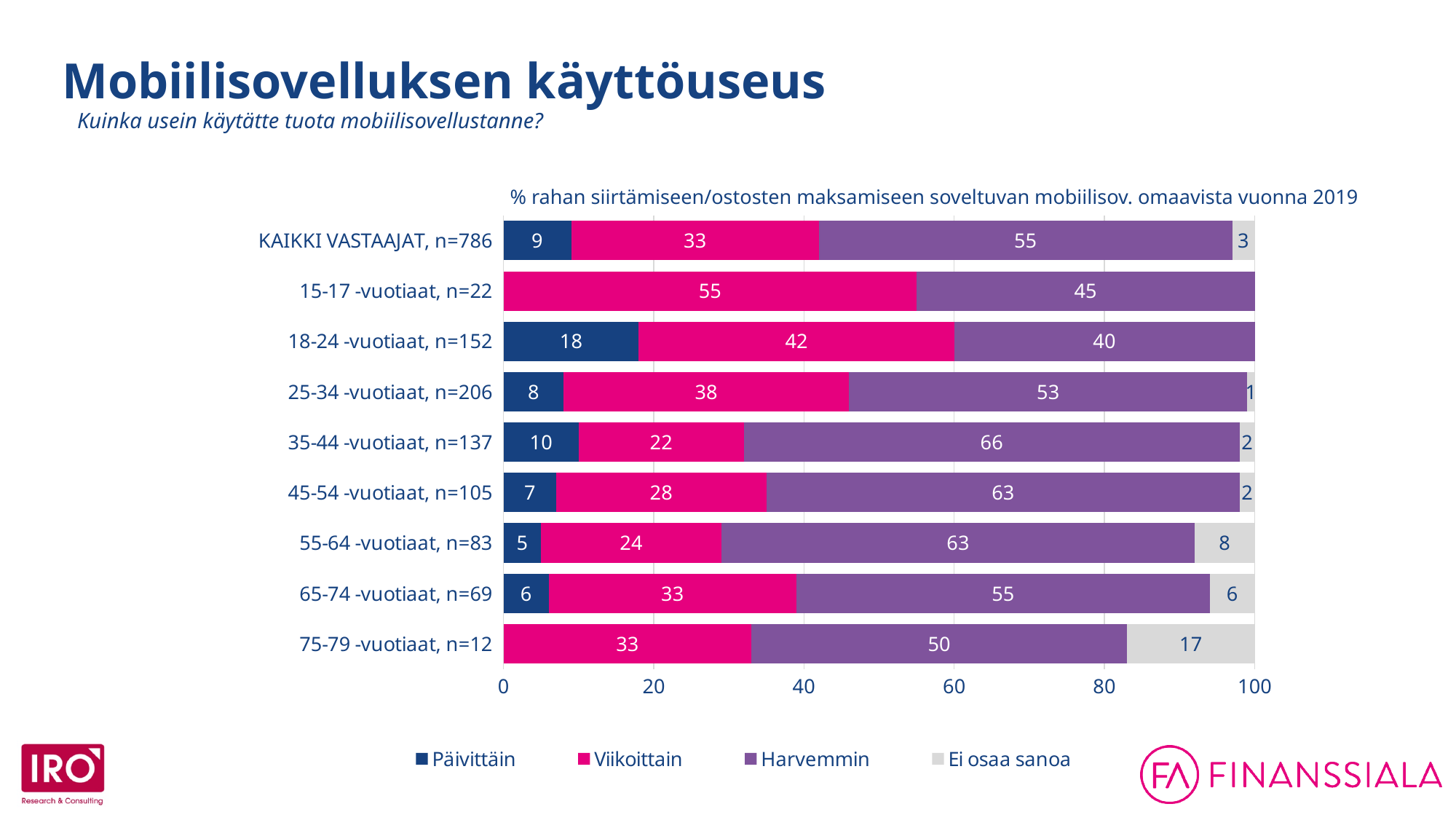
What is the total of the stacked bar for KAIKKI VASTAAJAT, n=786? 100 Which group has the lowest Harvemmin value? 18-24 -vuotiaat, n=152 What is the difference between the Viikoittain values for 15-17 -vuotiaat, n=22 and 35-44 -vuotiaat, n=137? 33 What is the Ei osaa sanoa value for 75-79 -vuotiaat, n=12? 17 How many series does the legend list? 4 What kind of chart is shown on the slide? stacked bar chart Which legend entry is shown in pink? Viikoittain Which is larger: the Ei osaa sanoa value for 55-64 -vuotiaat, n=83 or for 65-74 -vuotiaat, n=69? 55-64 -vuotiaat, n=83 What is the Päivittäin value for 18-24 -vuotiaat, n=152? 18 What is the Harvemmin value for 35-44 -vuotiaat, n=137? 66 How many respondent groups (bars) are shown in the chart? 9 Which group has the highest Päivittäin value? 18-24 -vuotiaat, n=152